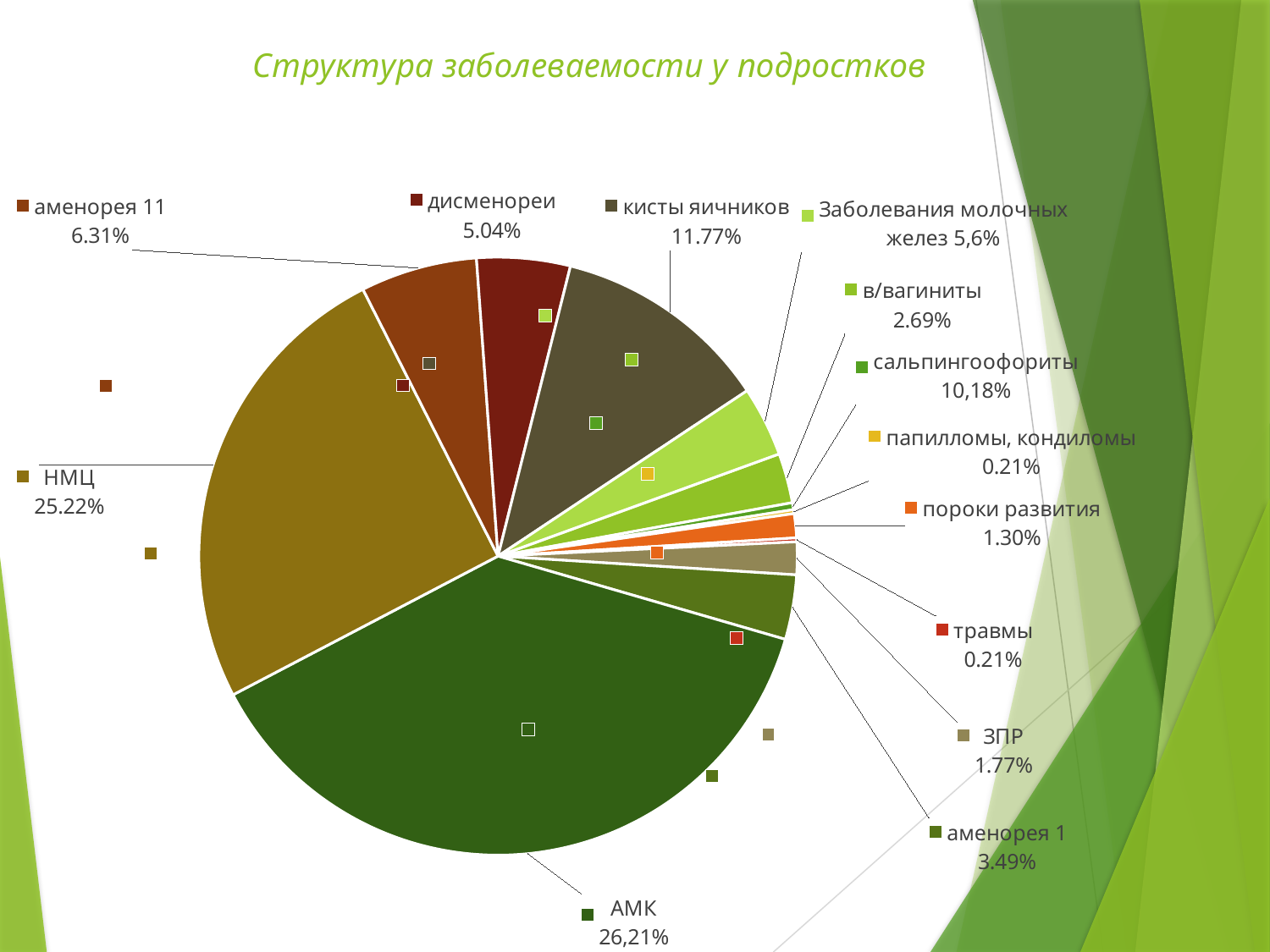
What percentage is shown for кисты яичников? 11.77% What is the value for сальпингоофориты? 10,18% What share of the pie does АМК account for? 26,21% What is the value shown for НМЦ? 25.22% How many categories are shown in the pie chart? 13 What is the difference between the values for аменорея 11 and дисменореи? 1.27% What is the title of the chart? Структура заболеваемости у подростков What is the difference between the values for НМЦ and кисты яичников? 13.45% Which category has the largest share of the pie? АМК What type of chart is shown on the slide? pie chart What percentage is shown for пороки развития? 1.30% Which is larger, в/вагиниты or аменорея 1? аменорея 1